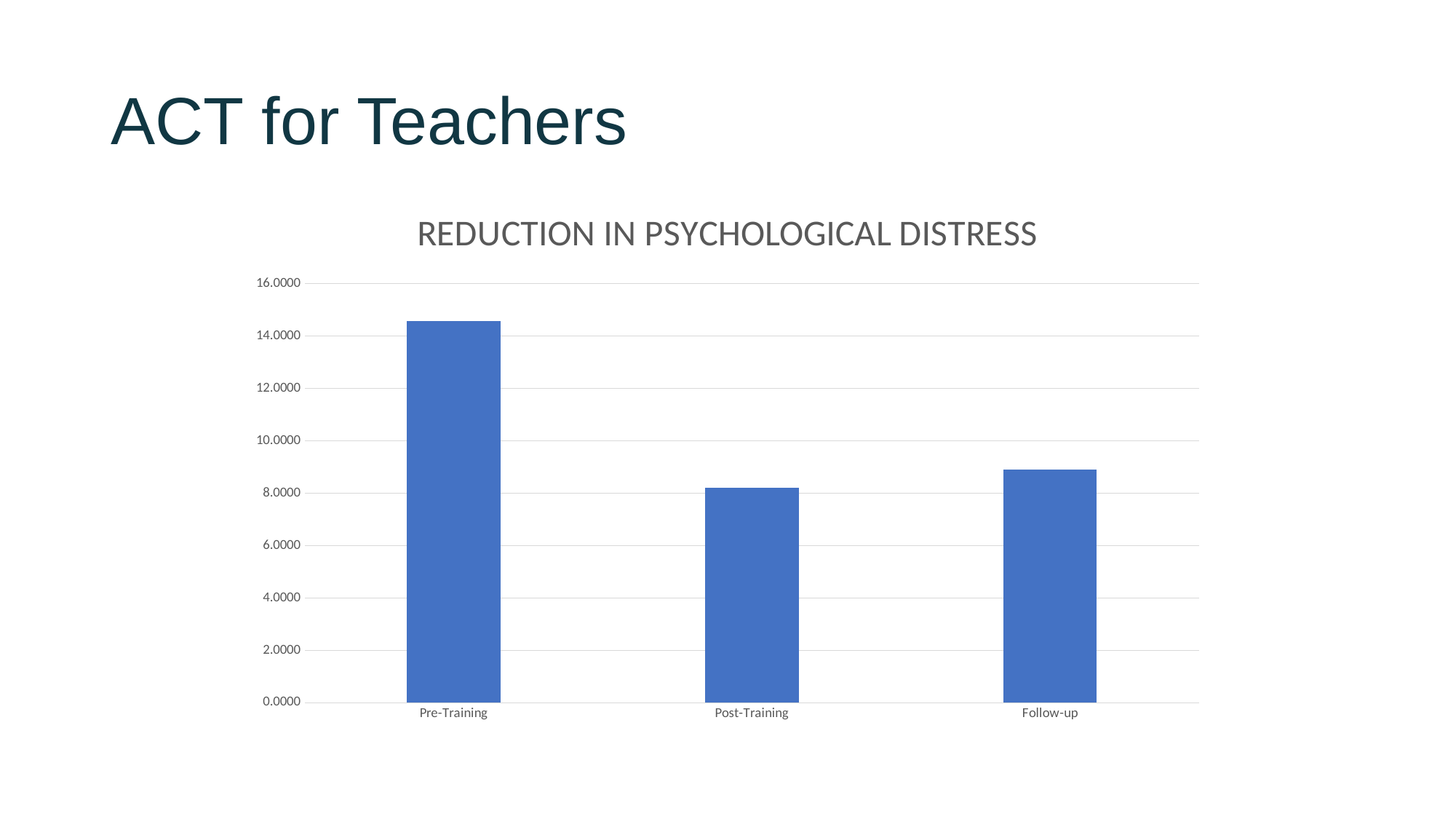
Which category has the lowest value in the chart? Post-Training Is the value for Follow-up greater or less than 8.0000? greater Is the value for Follow-up greater or less than 10.0000? less What is the title of the chart? REDUCTION IN PSYCHOLOGICAL DISTRESS Which is larger, the value for Post-Training or the value for Follow-up? Follow-up What type of chart is shown on the slide? bar chart Does the value rise or fall from Pre-Training to Post-Training? fall Which is larger, the value for Pre-Training or the value for Follow-up? Pre-Training Is the value for Pre-Training greater or less than 12.0000? greater How many categories are shown on the x axis of the chart? 3 Which category has the highest value in the chart? Pre-Training